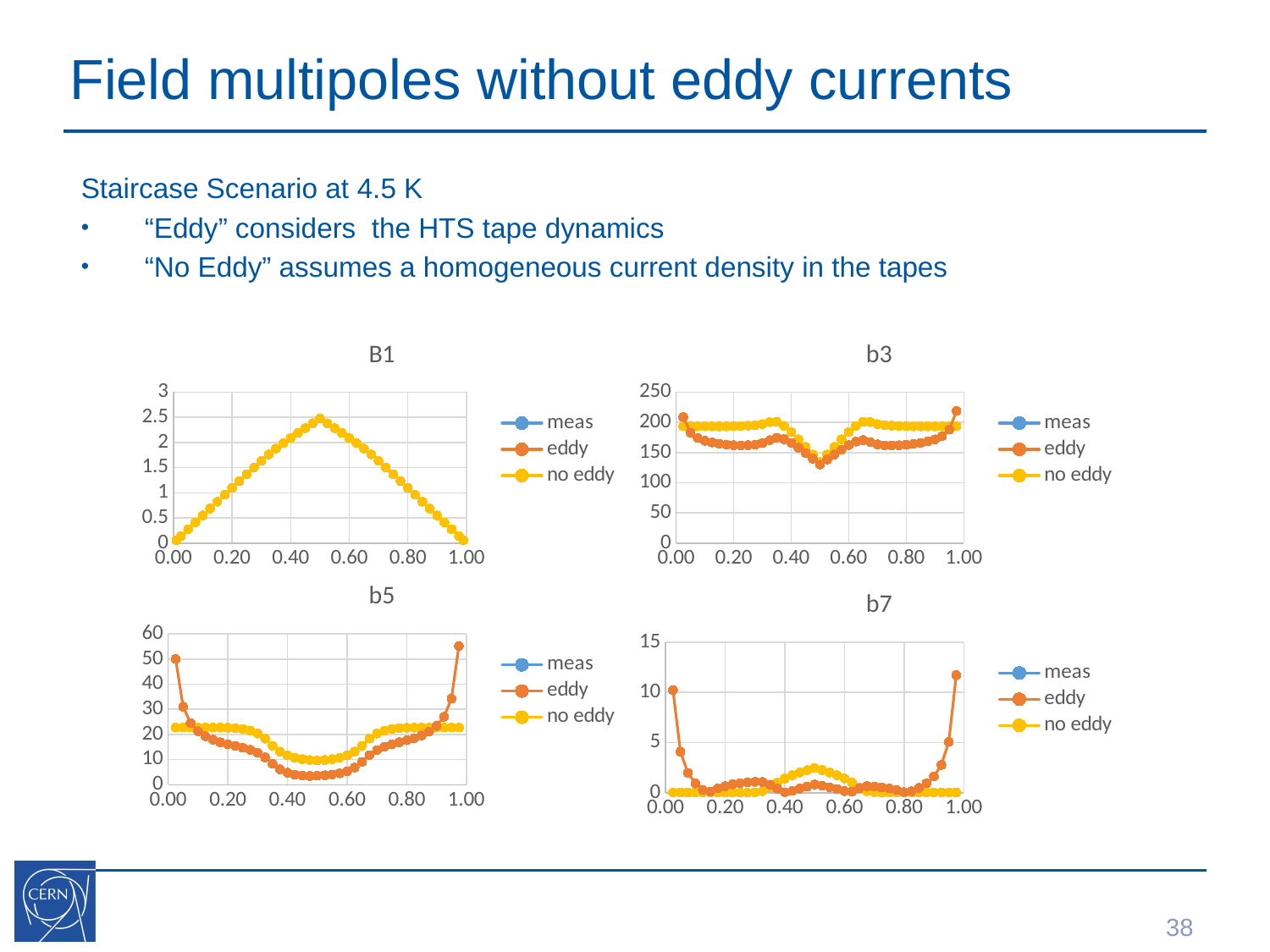
How many charts are shown on the slide? 4 In the b5 chart, is the no eddy value at x = 0.50 greater or less than 20? less In the B1 chart, do the values rise or fall along the x axis from 0.00 to 0.50? rise In the b3 chart, is the eddy value at x = 0.50 greater or less than 150? less How many series does the legend of the b3 chart list? 3 In the b7 chart, at x = 0.50, which series has the larger value, eddy or no eddy? no eddy In the B1 chart, is the value at x = 0.50 greater or less than 2? greater What kind of chart is the B1 chart? line chart What is the title of the chart in the bottom-right position of the slide? b7 In the b3 chart, at x = 0.20, which series has the larger value, eddy or no eddy? no eddy